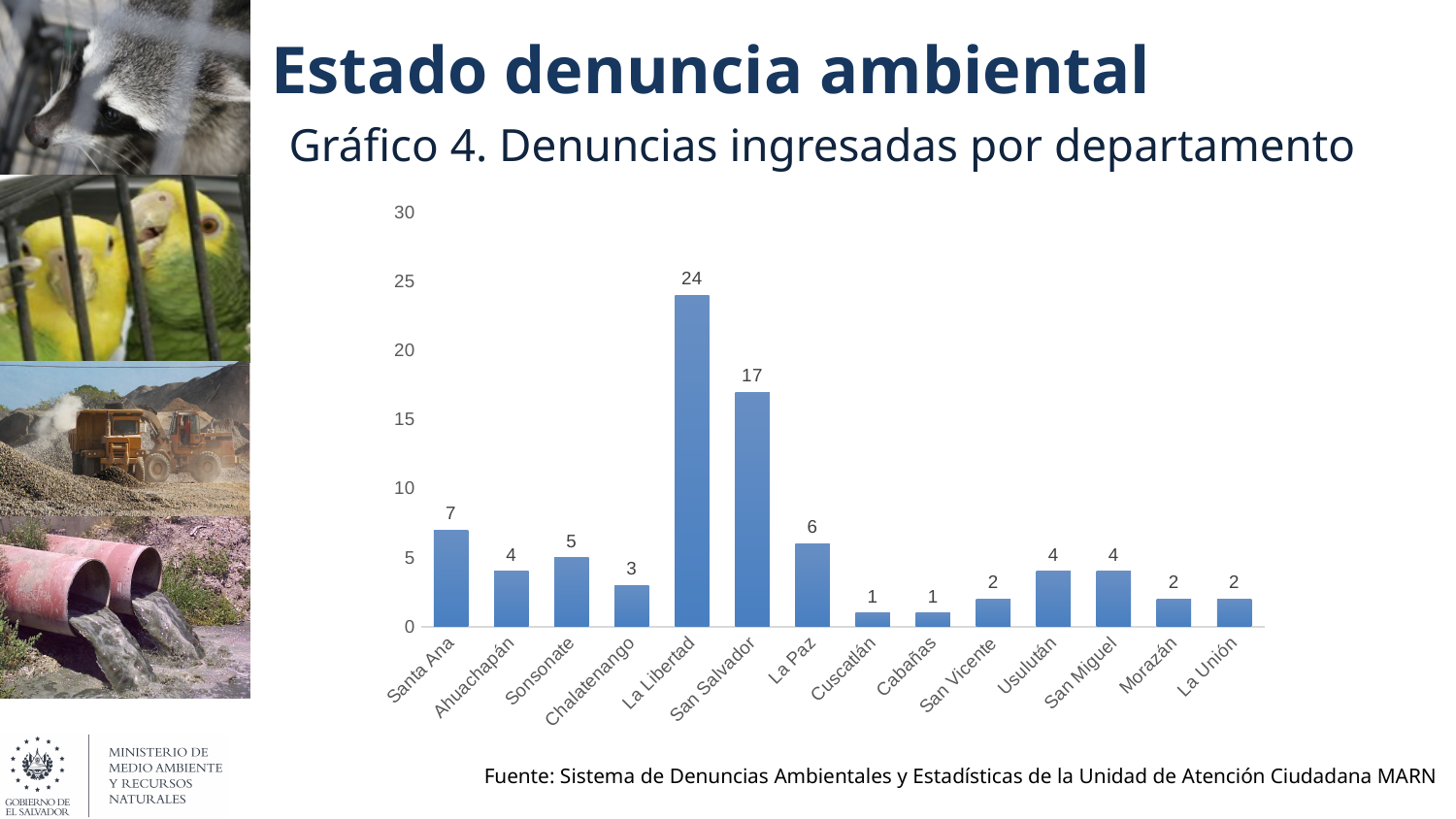
Is the value for San Salvador greater or less than 15? greater What type of chart is shown on the slide? Bar chart Which is larger, the value for La Paz or the value for Sonsonate? La Paz What is the difference between the values for Santa Ana and Ahuachapán? 3 How many departments are shown on the x axis of the chart? 14 What is the value for Chalatenango? 3 What is the value for La Libertad? 24 Which department has the highest number of denuncias ingresadas? La Libertad What is the value for San Salvador? 17 What is the difference between the values for La Libertad and San Salvador? 7 What is the value for Santa Ana? 7 What is the title of the chart? Gráfico 4. Denuncias ingresadas por departamento